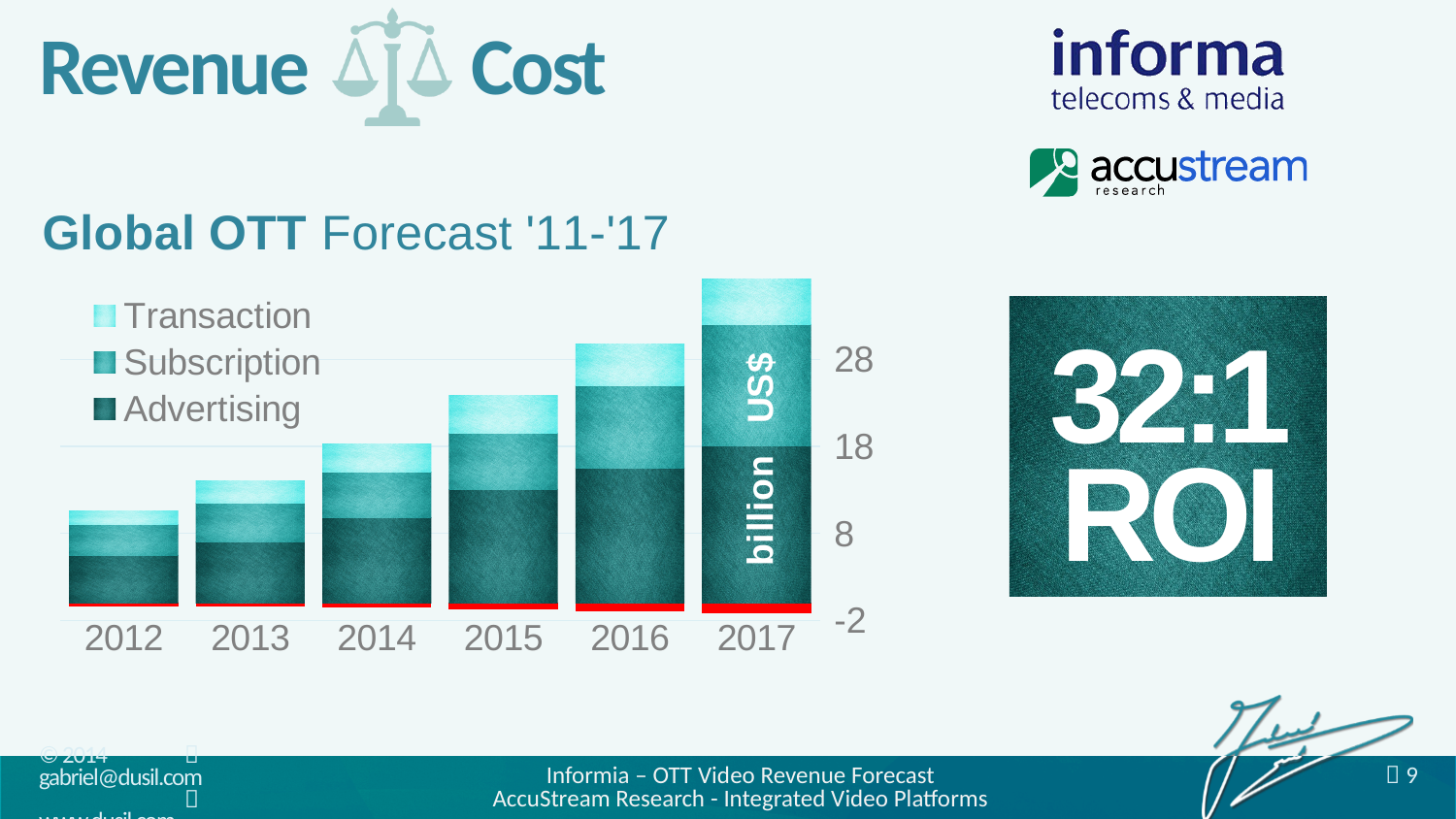
How many series does the legend of the Global OTT Forecast chart list? 3 What unit is shown on the y axis of the Global OTT Forecast chart? US$ billion What kind of chart is shown on the slide? Stacked bar chart Which year has the tallest stacked bar in the Global OTT Forecast chart? 2017 Do the total bar heights rise or fall from 2012 to 2017? Rise Which series is listed first in the legend of the Global OTT Forecast chart? Transaction Which year has a larger total bar, 2013 or 2016? 2016 Which year has the shortest stacked bar in the Global OTT Forecast chart? 2012 Is the total bar for 2015 greater or less than 28? less How many years are shown on the x axis of the Global OTT Forecast chart? 6 Is the total bar for 2012 greater or less than 18? less Is the total bar for 2017 greater or less than 28? greater